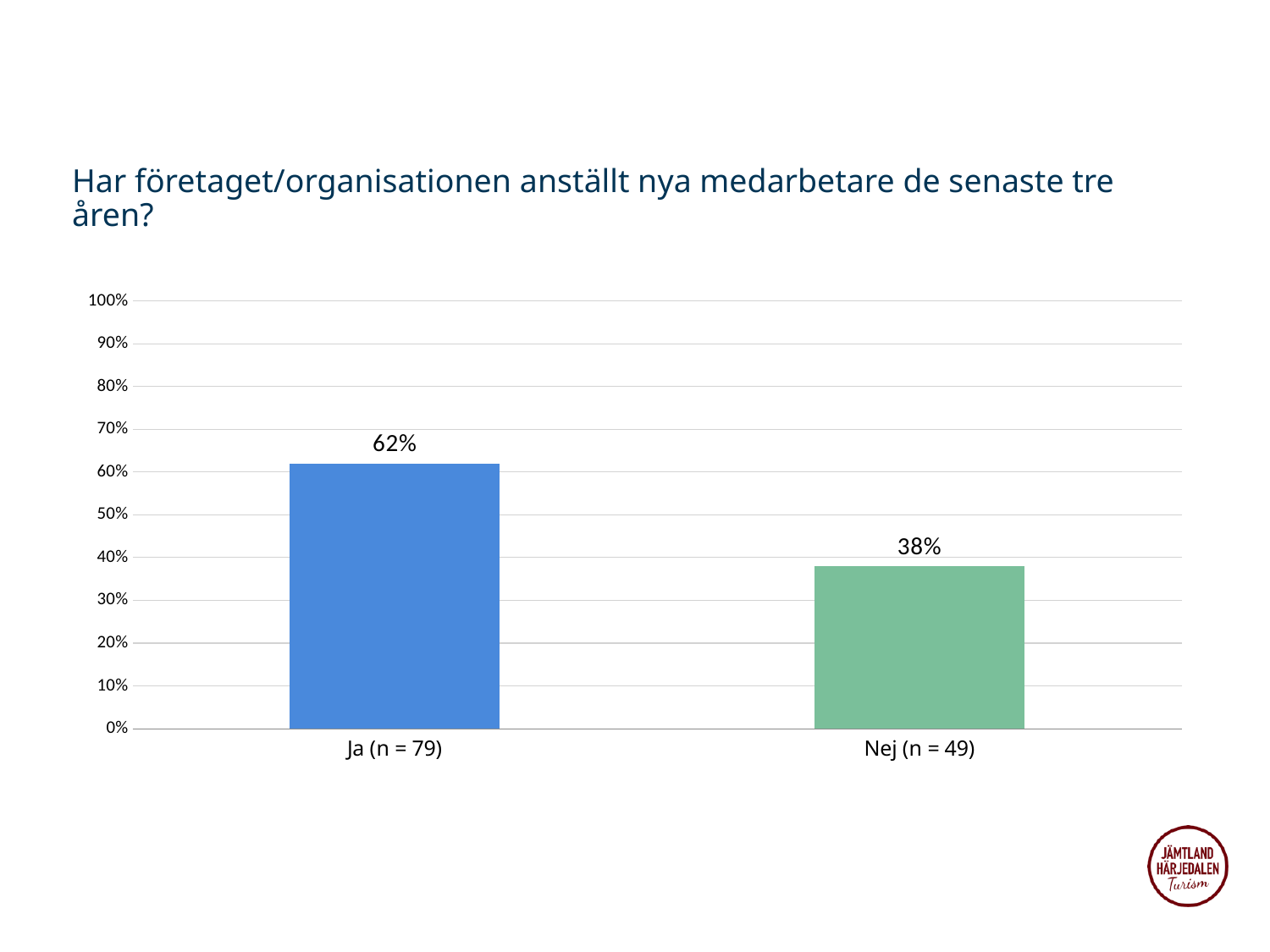
What colour is the bar for "Nej (n = 49)"? green Which is larger, the value for "Ja (n = 79)" or the value for "Nej (n = 49)"? Ja (n = 79) What is the difference between the values for "Ja (n = 79)" and "Nej (n = 49)"? 24% What kind of chart is shown on the slide? bar chart Is the value for "Ja (n = 79)" greater or less than 50%? greater Which category has the lowest value? Nej (n = 49) What is the value for "Ja (n = 79)"? 62% What is the value for "Nej (n = 49)"? 38% How many categories are shown in the chart? 2 Which category has the highest value? Ja (n = 79) Is the value for "Nej (n = 49)" greater or less than 50%? less What is the title of the slide? Har företaget/organisationen anställt nya medarbetare de senaste tre åren?